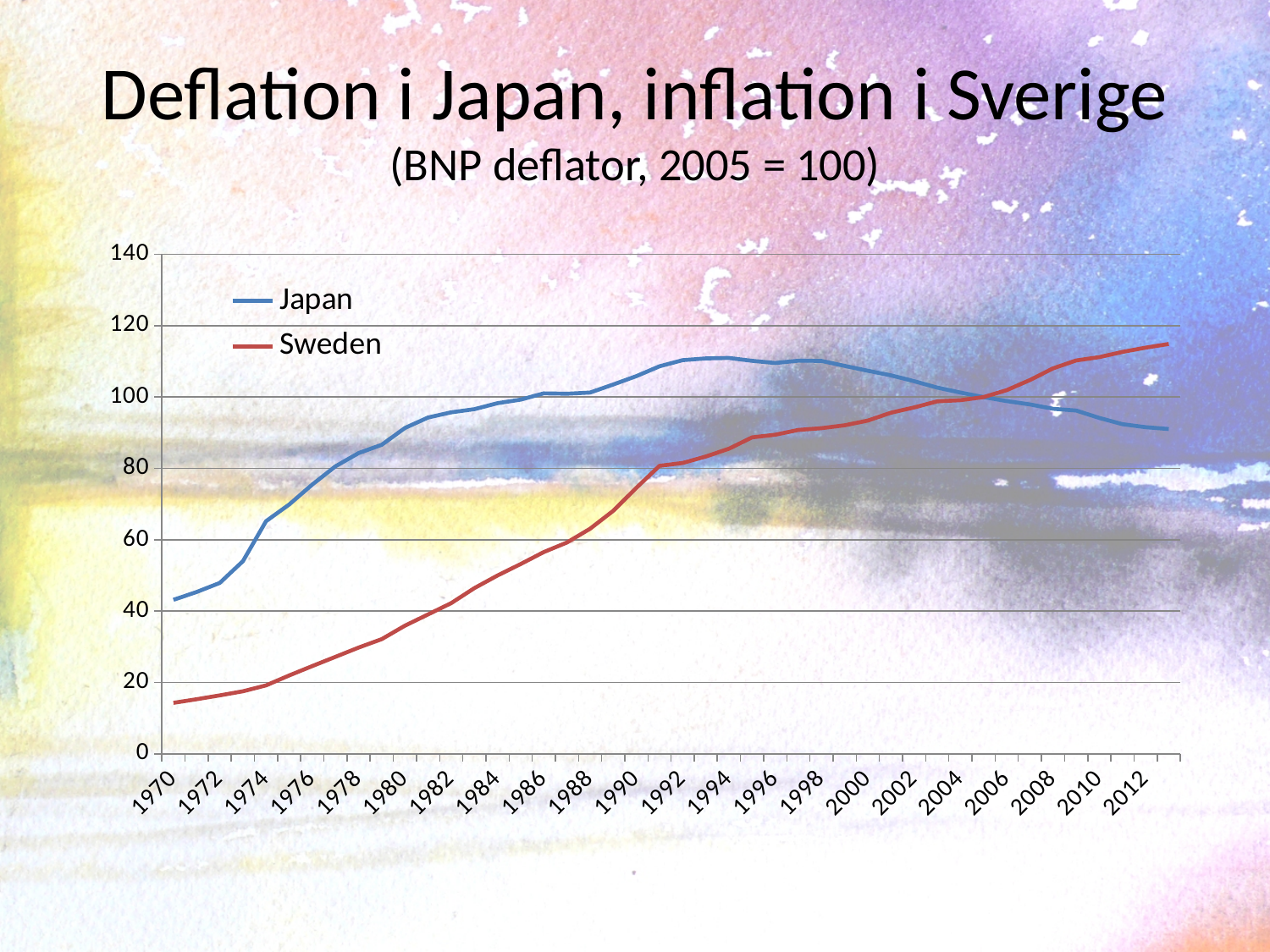
Is the value for Sweden in 1970 greater or less than 20? less What colour is the line for Japan? blue Does the Sweden line rise or fall from 1970 to 2012? rise Is the value for Japan in 2012 greater or less than 100? less Is the value for Japan in 1994 greater or less than 100? greater In 1980, which series has the higher value, Japan or Sweden? Japan In 2010, which series has the higher value, Japan or Sweden? Sweden What kind of chart is shown on the slide? line chart How many series does the legend list? 2 Which two series are listed in the legend? Japan and Sweden